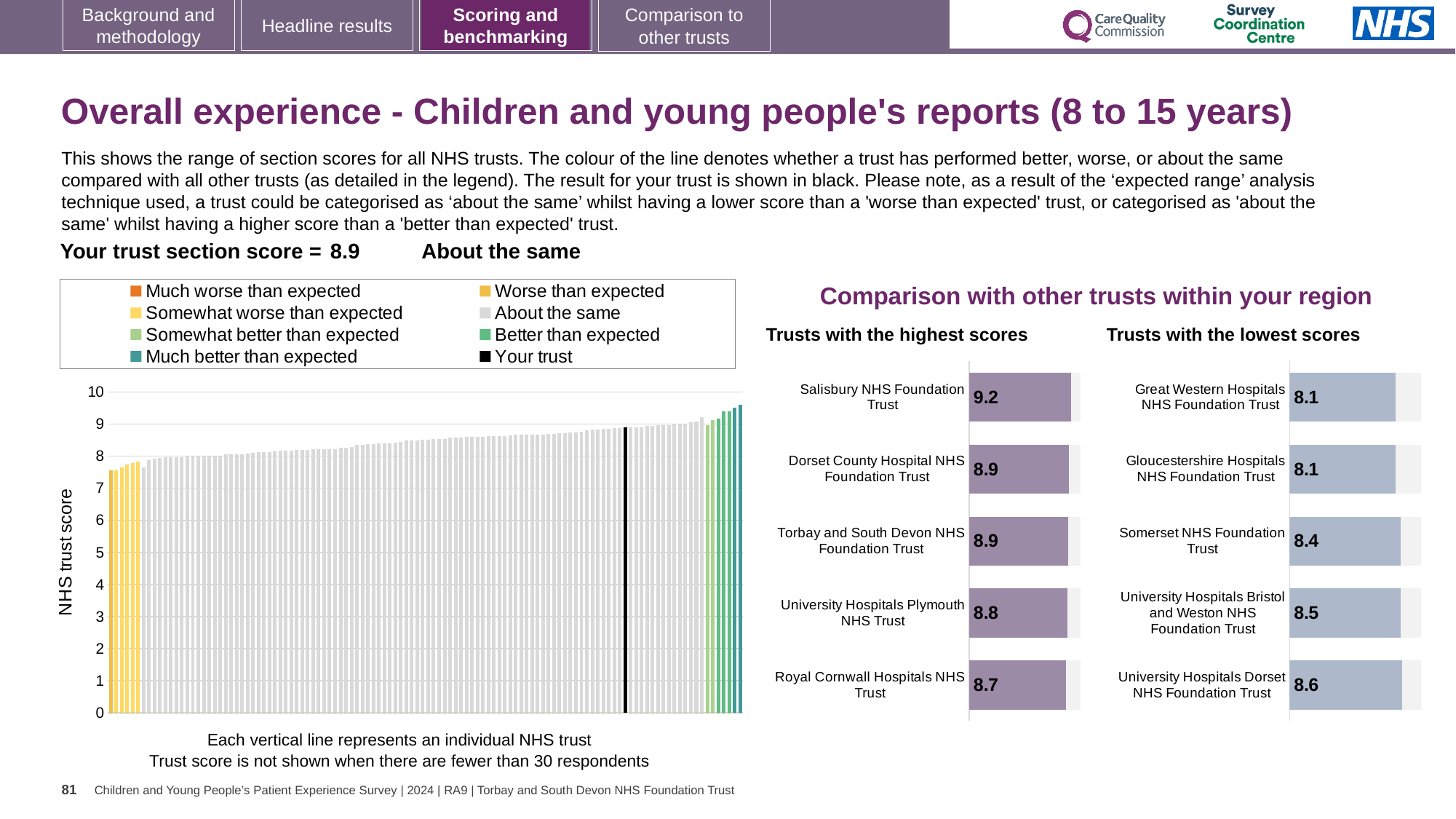
What kind of chart is the large chart on the left showing all NHS trusts? Bar chart In the large chart on the left showing all NHS trusts, what is the label on the vertical axis? NHS trust score In the 'Trusts with the highest scores' chart, what is the score for Royal Cornwall Hospitals NHS Trust? 8.7 In the 'Trusts with the lowest scores' chart, which has the larger score: Somerset NHS Foundation Trust or University Hospitals Bristol and Weston NHS Foundation Trust? University Hospitals Bristol and Weston NHS Foundation Trust In the large chart on the left showing all NHS trusts, is the value for the black bar (your trust) greater or less than 8? greater In the 'Trusts with the highest scores' chart, what is the score for Salisbury NHS Foundation Trust? 9.2 In the 'Trusts with the lowest scores' chart, what is the difference between the scores of University Hospitals Dorset NHS Foundation Trust and Great Western Hospitals NHS Foundation Trust? 0.5 In the 'Trusts with the highest scores' chart, which trust has the lowest score? Royal Cornwall Hospitals NHS Trust In the 'Trusts with the highest scores' chart, which trust has the highest score? Salisbury NHS Foundation Trust In the 'Trusts with the lowest scores' chart, what is the score for Somerset NHS Foundation Trust? 8.4 In the 'Trusts with the lowest scores' chart, which trust has the highest score? University Hospitals Dorset NHS Foundation Trust In the 'Trusts with the highest scores' chart, how many trusts are shown? 5